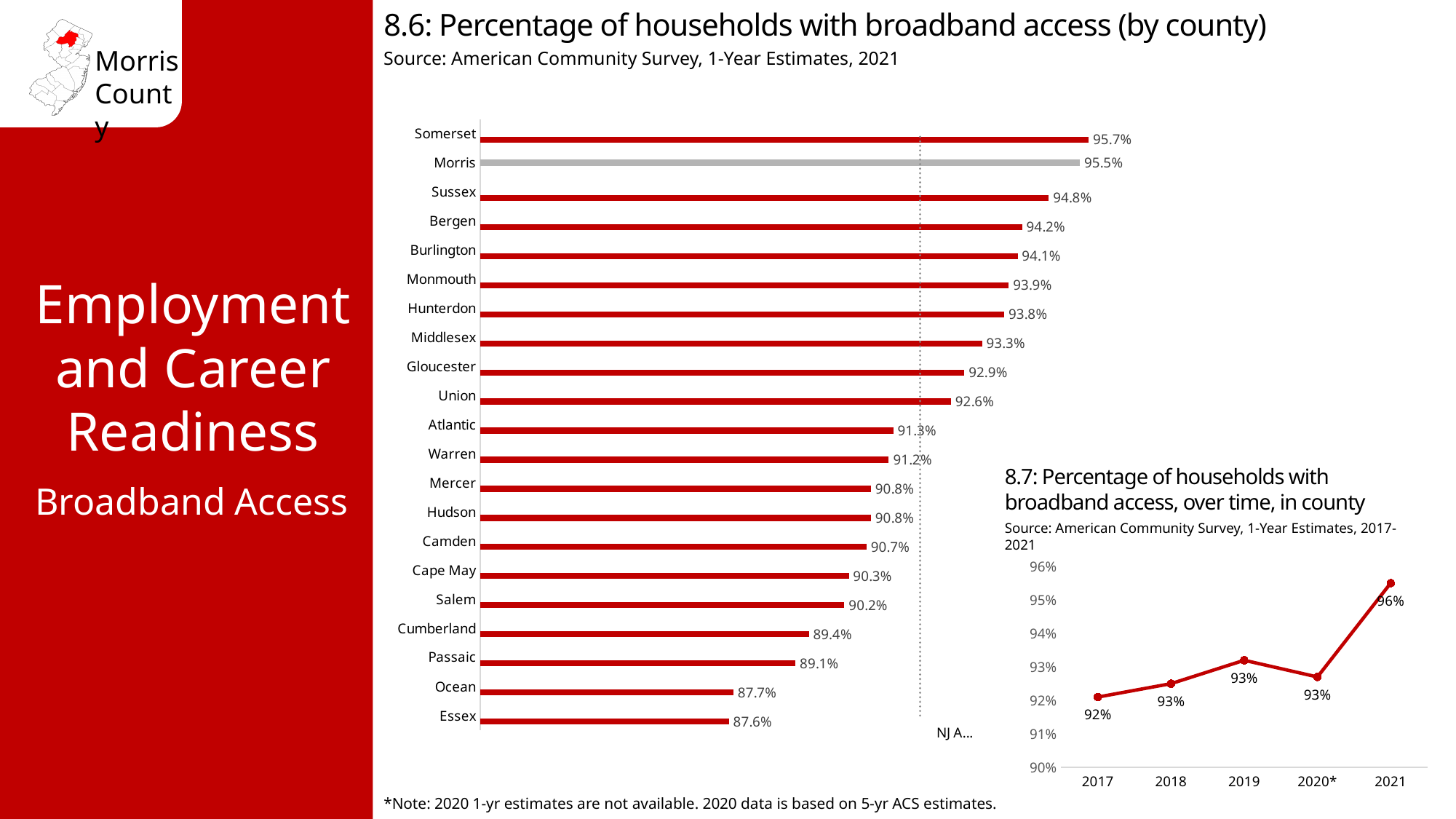
In chart 8.7, how many data points are plotted? 5 In chart 8.6, which county's bar is coloured grey instead of red? Morris In chart 8.6, which county has the highest percentage of households with broadband access? Somerset In chart 8.6, which county has the lowest percentage of households with broadband access? Essex In chart 8.6, what is the difference in percentage points between Somerset and Essex? 8.1 In chart 8.6, what is the value shown for Cumberland? 89.4% What kind of chart is chart 8.6? Bar chart In chart 8.6, what is the percentage of households with broadband access in Morris County? 95.5% In chart 8.7, do the values generally rise or fall from 2017 to 2021? Rise In chart 8.7, what is the value shown for 2017? 92% In chart 8.6, which county has a higher value, Bergen or Passaic? Bergen In chart 8.6, how many counties are shown? 21